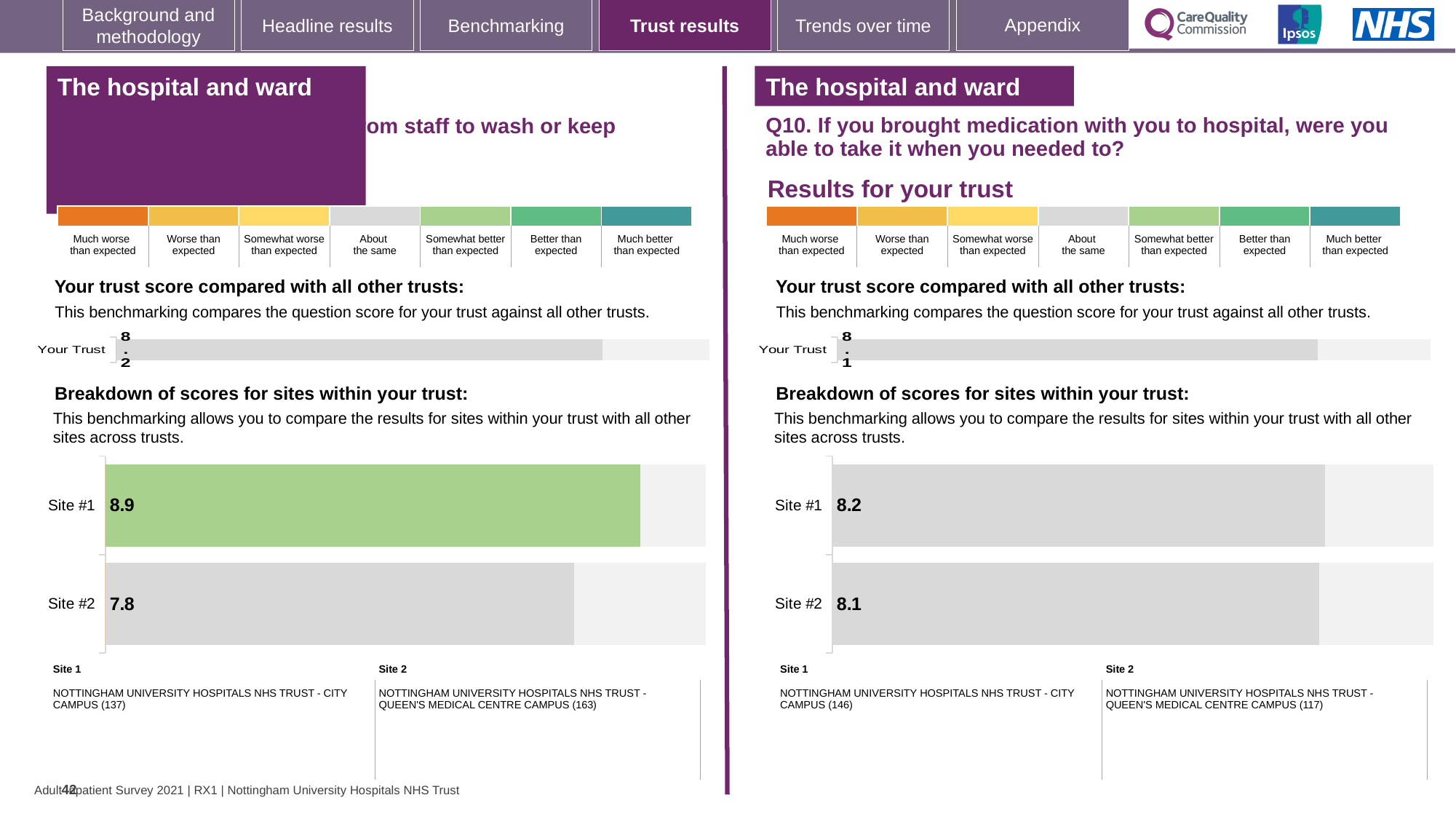
In the right-hand (Q10) site breakdown chart, what is the score for Site #1? 8.2 In the left-hand site breakdown chart, what is the difference between the Site #1 and Site #2 scores? 1.1 In the left-hand site breakdown chart, what colour is the bar for Site #1? Green In the left-hand site breakdown chart, what is the score for Site #1? 8.9 What type of chart is used for the site breakdown on the left-hand side of the slide? Bar chart How many sites are shown in the right-hand (Q10) site breakdown chart? 2 In the right-hand (Q10) site breakdown chart, what is the difference between the Site #1 and Site #2 scores? 0.1 In the left-hand site breakdown chart, which site has the higher score? Site #1 In the left-hand site breakdown chart, what is the score for Site #2? 7.8 In the right-hand (Q10) 'Your trust score compared with all other trusts' chart, what is the score for Your Trust? 8.1 In the right-hand (Q10) site breakdown chart, what is the score for Site #2? 8.1 In the left-hand 'Your trust score compared with all other trusts' chart, what is the score for Your Trust? 8.2